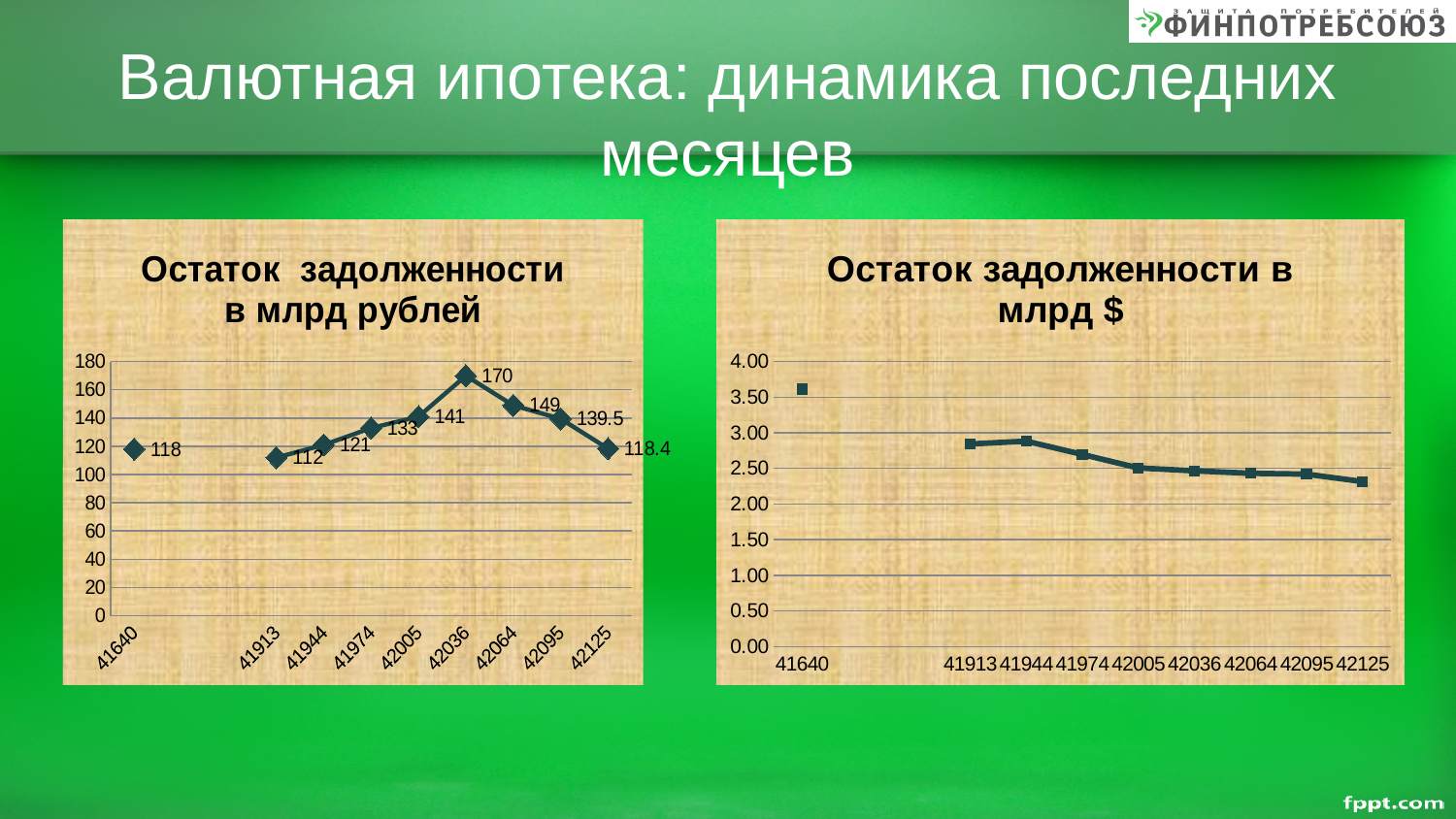
In the chart titled "Остаток задолженности в млрд рублей", how many data points are plotted? 9 In the chart titled "Остаток задолженности в млрд $", is the value for 42125 greater or less than 2.50? less In the chart titled "Остаток задолженности в млрд $", is the value for 41640 greater or less than 3.00? greater In the chart titled "Остаток задолженности в млрд рублей", what is the value for 41913? 112 In the chart titled "Остаток задолженности в млрд рублей", which category has the highest value? 42036 In the chart titled "Остаток задолженности в млрд рублей", what is the value for 42125? 118.4 In the chart titled "Остаток задолженности в млрд рублей", which is larger, the value for 41640 or the value for 42125? 42125 In the chart titled "Остаток задолженности в млрд $", do the values generally rise or fall from 41913 to 42125? fall What kind of chart is the chart titled "Остаток задолженности в млрд $"? line chart In the chart titled "Остаток задолженности в млрд рублей", what is the value for 42036? 170 In the chart titled "Остаток задолженности в млрд рублей", what is the difference between the values for 42036 and 42064? 21 In the chart titled "Остаток задолженности в млрд рублей", which category has the lowest value? 41913